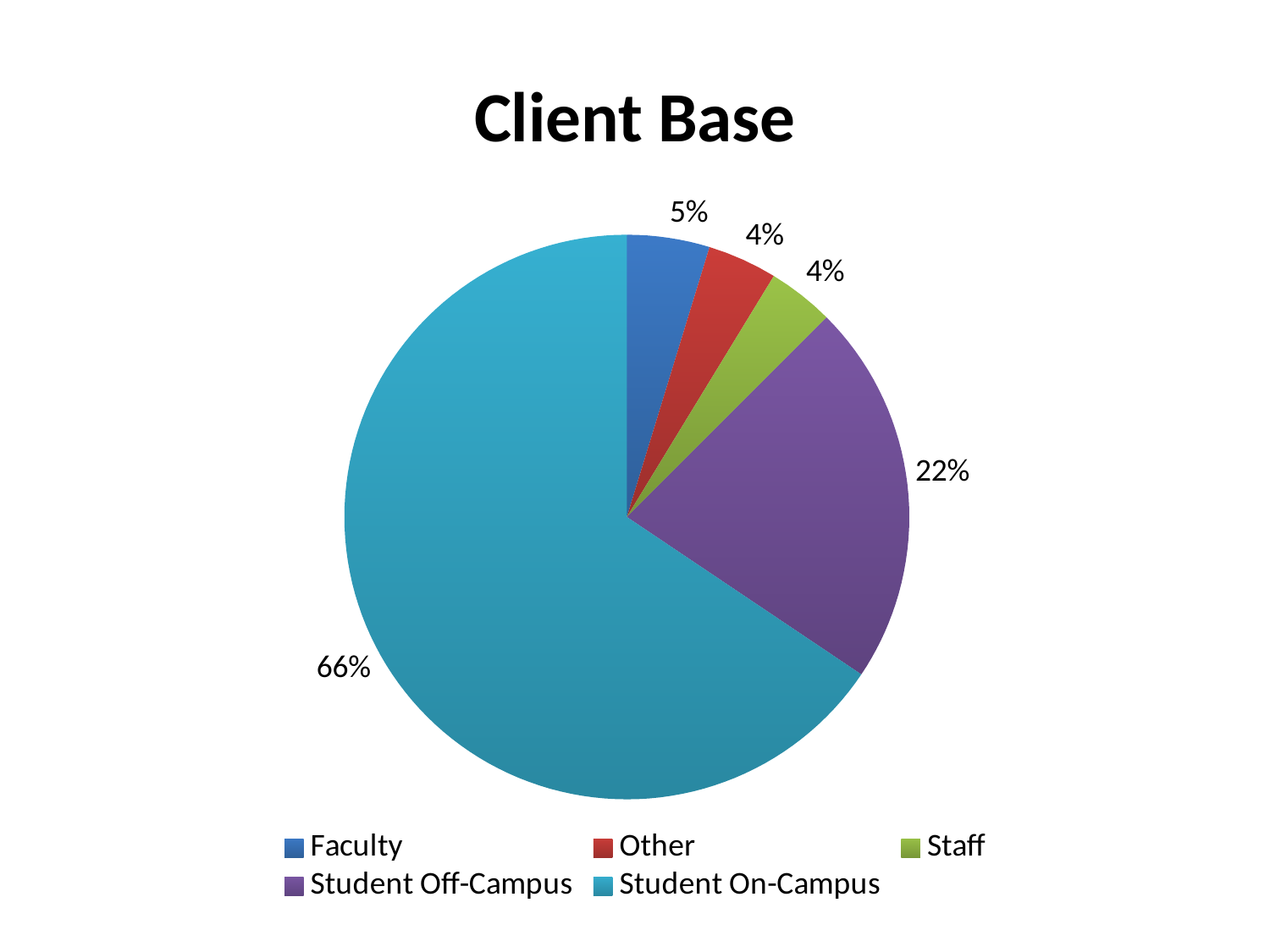
Which is larger, the Faculty slice or the Student Off-Campus slice? Student Off-Campus What share of the pie does Student On-Campus represent? 66% Which category has the largest slice of the pie? Student On-Campus What is the value for Staff? 4% What kind of chart is shown on the slide? pie chart What is the difference between the Student On-Campus and Student Off-Campus shares? 44% What share of the pie does Student Off-Campus represent? 22% What is the value for Faculty? 5% How many categories does the legend list? 5 What colour is the Student Off-Campus slice? purple What is the title of the chart? Client Base What is the difference between the Faculty and Other shares? 1%